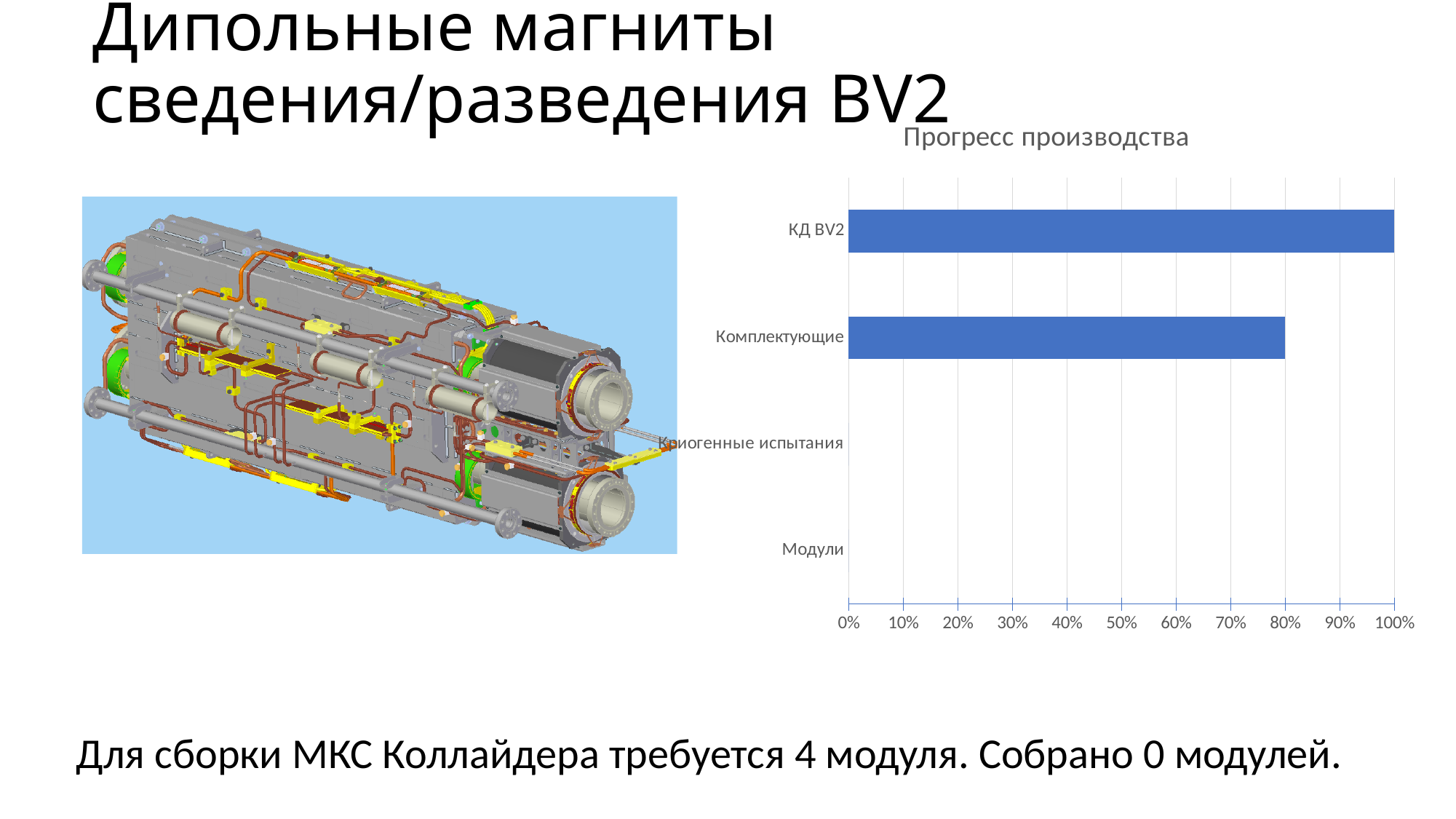
What type of chart is shown on the slide? bar chart Which category has the highest value? КД BV2 Is the value for Комплектующие greater or less than 50%? greater What is the value for КД BV2? 100% What is the title of the chart? Прогресс производства Which is larger, the value for КД BV2 or the value for Комплектующие? КД BV2 Is the value for Криогенные испытания greater or less than 10%? less Is the value for Модули greater or less than 10%? less How many categories are shown on the chart? 4 What is the value for Комплектующие? 80% What is the difference between the values for КД BV2 and Комплектующие? 20% What is the maximum value shown on the horizontal axis? 100%